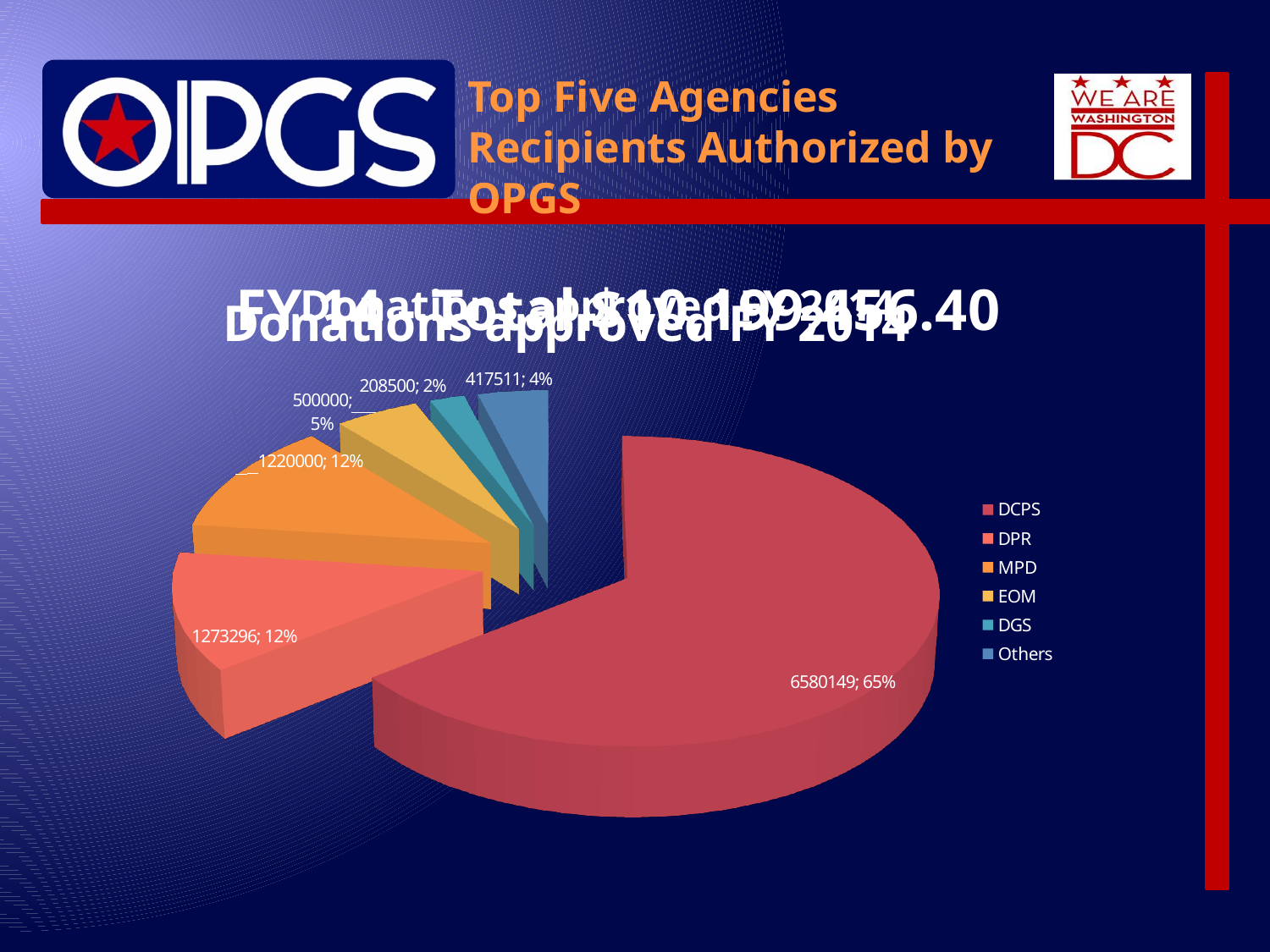
How many entries does the legend list? 6 What value is shown for the DGS slice? 208500 How many slices does the pie chart have? 6 What percentage share does the EOM slice have? 5% What value is shown for the DCPS slice? 6580149 What kind of chart is shown on the slide? pie chart What percentage share does the DCPS slice have? 65% What value is shown for the DPR slice? 1273296 What value is shown for the MPD slice? 1220000 Which category has the smallest slice of the pie? DGS What is the difference between the DPR value and the MPD value? 53296 Which agency has the largest slice of the pie? DCPS